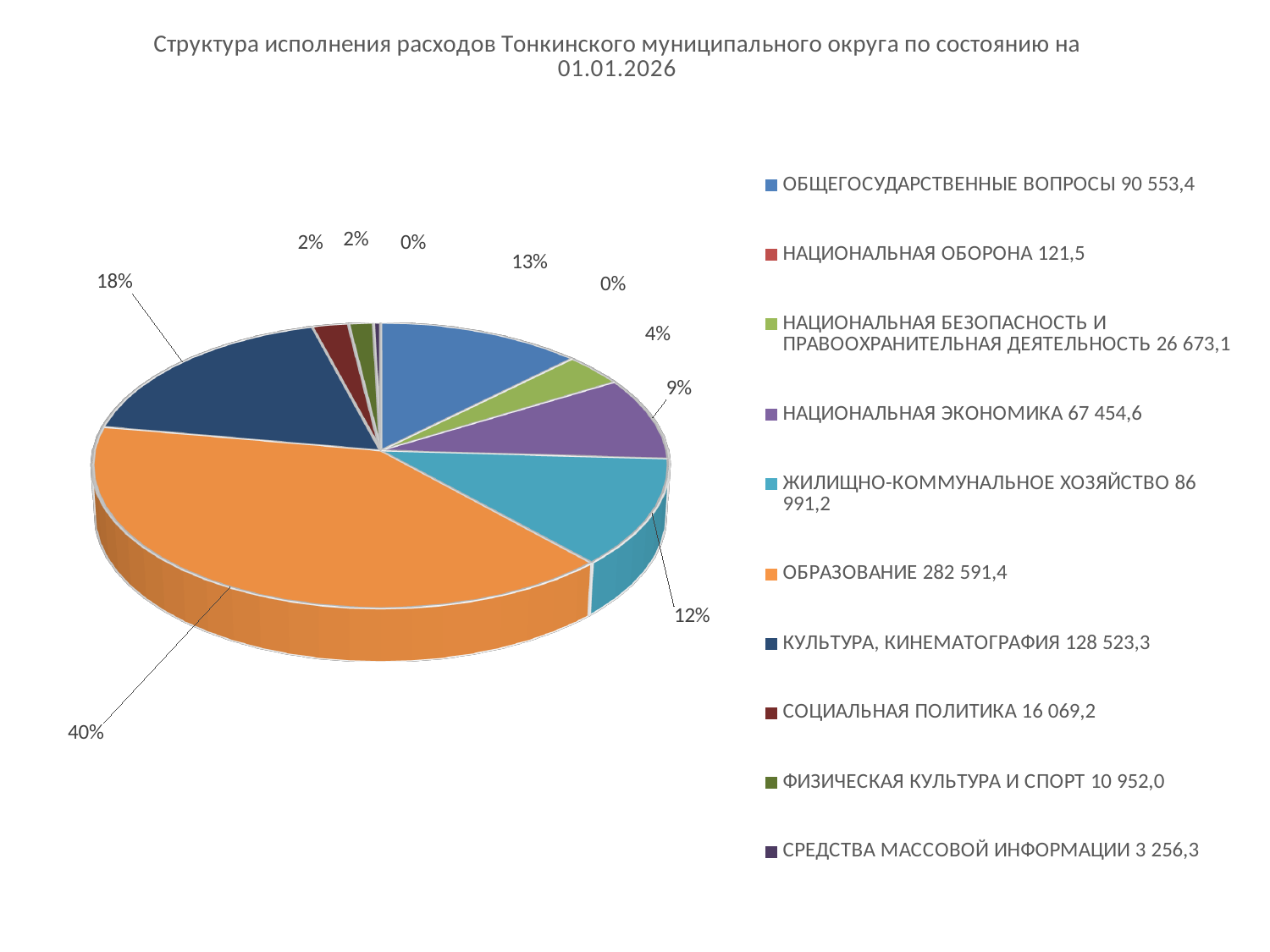
What share of the pie does КУЛЬТУРА, КИНЕМАТОГРАФИЯ account for? 18% What share of the pie does ОБРАЗОВАНИЕ account for? 40% What value is shown in the legend for НАЦИОНАЛЬНАЯ ОБОРОНА? 121,5 What is the difference in percentage points between the share for ОБРАЗОВАНИЕ and the share for КУЛЬТУРА, КИНЕМАТОГРАФИЯ? 22 percentage points Which is larger: the share for НАЦИОНАЛЬНАЯ ЭКОНОМИКА or the share for НАЦИОНАЛЬНАЯ БЕЗОПАСНОСТЬ И ПРАВООХРАНИТЕЛЬНАЯ ДЕЯТЕЛЬНОСТЬ? НАЦИОНАЛЬНАЯ ЭКОНОМИКА What value is shown in the legend for СРЕДСТВА МАССОВОЙ ИНФОРМАЦИИ? 3 256,3 What kind of chart is shown on the slide? Pie chart What is the title of the chart? Структура исполнения расходов Тонкинского муниципального округа по состоянию на 01.01.2026 What share of the pie does ЖИЛИЩНО-КОММУНАЛЬНОЕ ХОЗЯЙСТВО account for? 12% How many categories does the legend of the pie chart list? 10 Which category has the largest slice of the pie? ОБРАЗОВАНИЕ What value is shown in the legend for ОБРАЗОВАНИЕ? 282 591,4